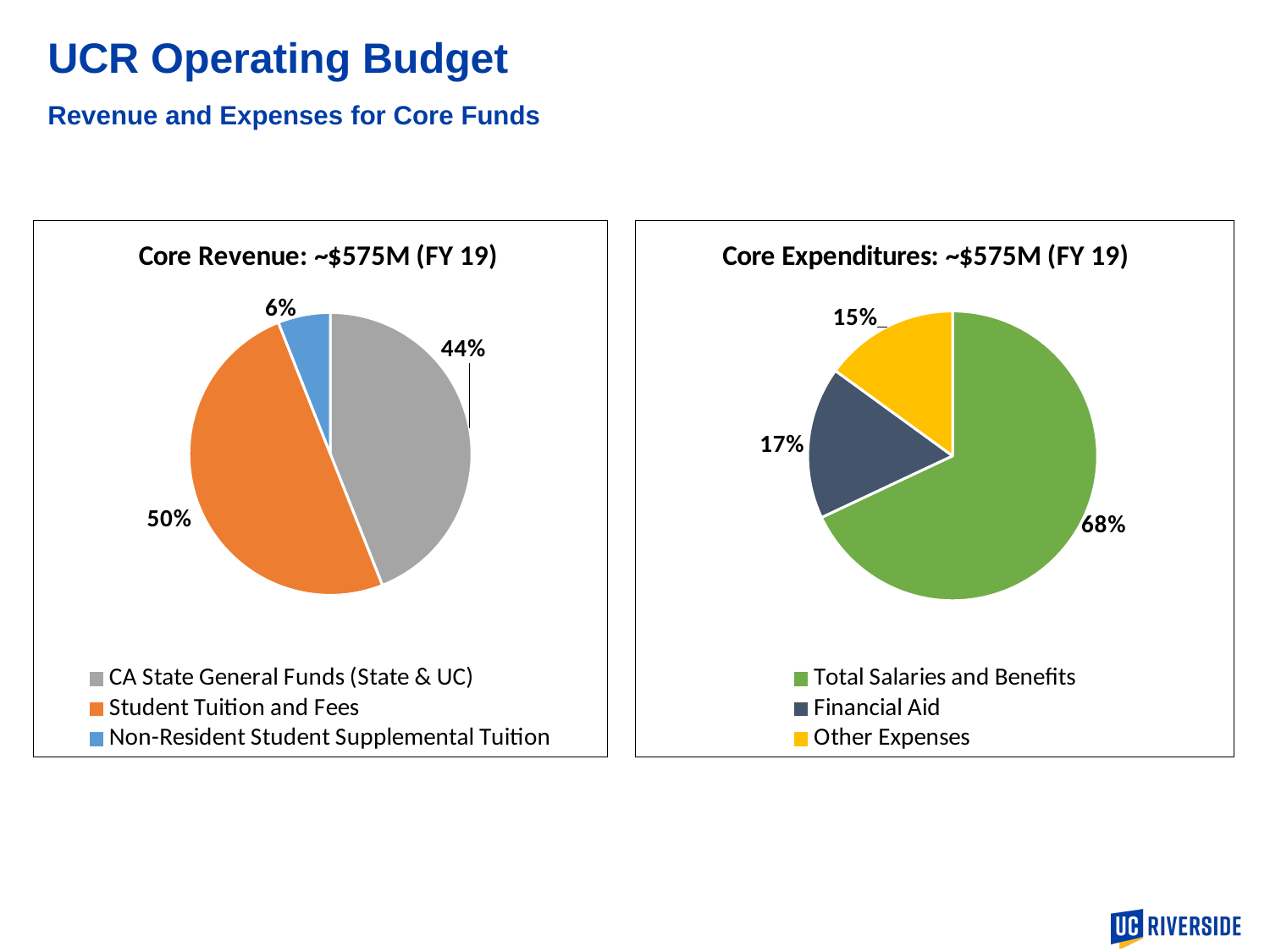
How many categories does the legend of the Core Expenditures chart list? 3 In the Core Revenue chart, which category has the smallest slice? Non-Resident Student Supplemental Tuition In the Core Expenditures chart, which category has the smallest slice? Other Expenses In the Core Revenue chart, what share does Non-Resident Student Supplemental Tuition account for? 6% In the Core Revenue chart, which category has the largest slice? Student Tuition and Fees In the Core Expenditures chart, what share does Other Expenses account for? 15% In the Core Revenue chart, what share does Student Tuition and Fees account for? 50% What kind of chart is the Core Revenue chart? Pie chart In the Core Expenditures chart, what is the difference in percentage points between Total Salaries and Benefits and Financial Aid? 51